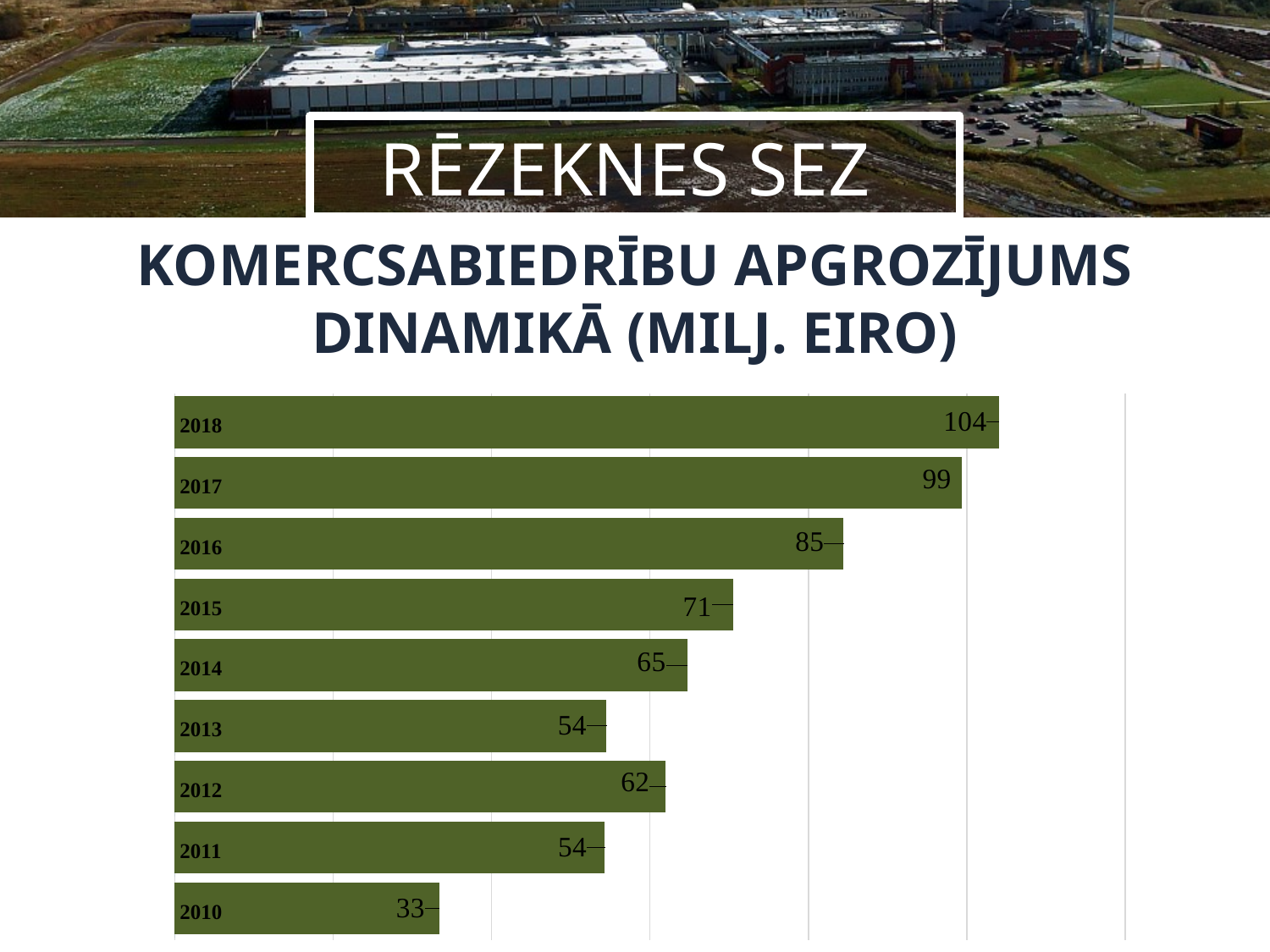
Do the values generally rise or fall from 2010 to 2018? rise Which is larger, the value for 2012 or the value for 2013? 2012 What is the value for 2015? 71 What is the difference between the values for 2018 and 2017? 5 What is the title of the chart? KOMERCSABIEDRĪBU APGROZĪJUMS DINAMIKĀ (MILJ. EIRO) How many years are shown in the chart? 9 What is the value for 2010? 33 Which year has the lowest value? 2010 What kind of chart is shown on the slide? bar chart What is the difference between the values for 2016 and 2010? 52 Which year has the highest value? 2018 What is the value for 2018? 104